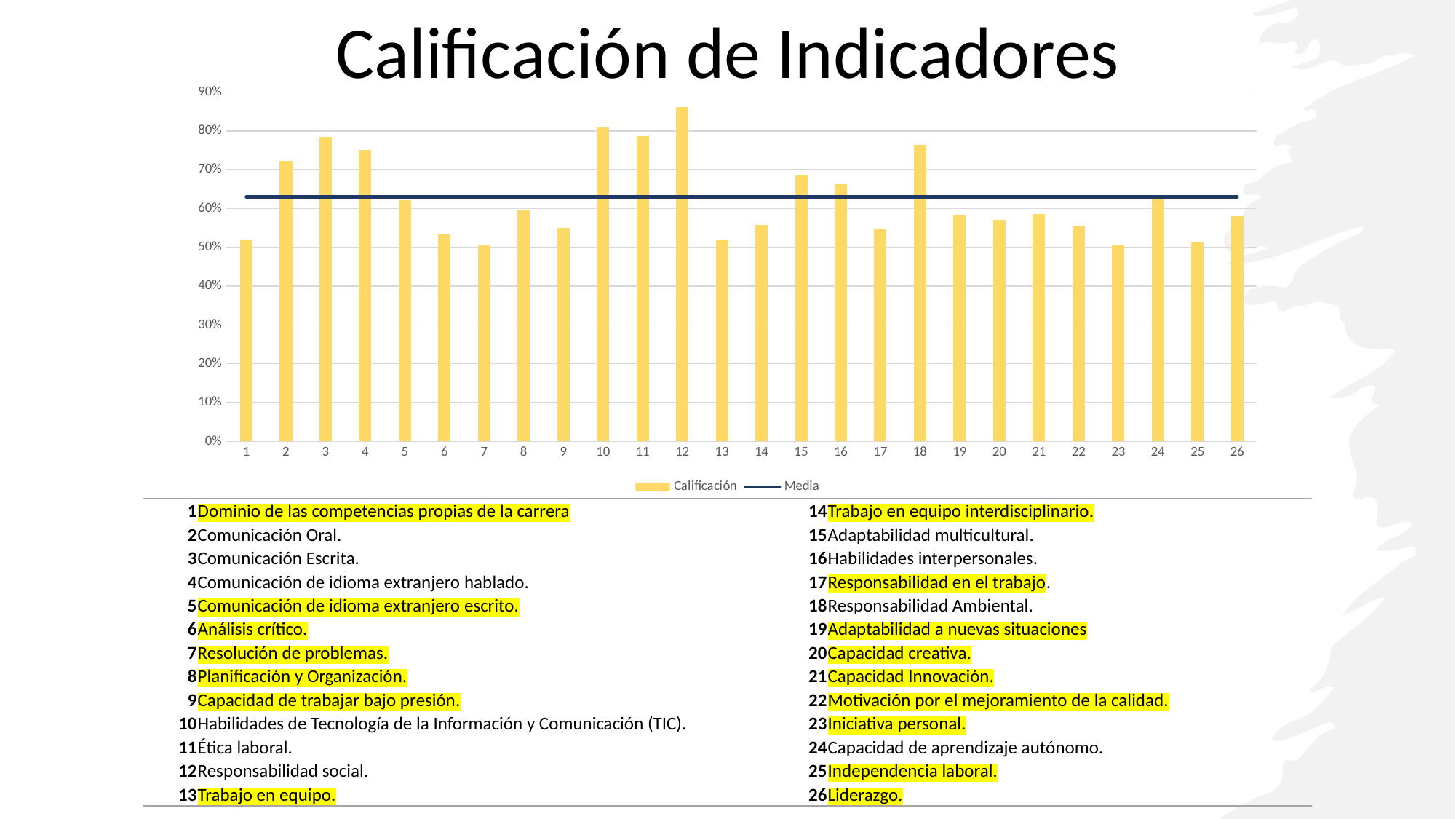
What is the title of the chart? Calificación de Indicadores Is the Calificación value for category 7 greater or less than 60%? less Which has the larger Calificación value, category 13 or category 10? 10 What kind of chart is shown on the slide? combination bar and line chart Which category has the highest Calificación bar? 12 Is the Calificación value for category 2 greater or less than 70%? greater What are the two entries in the chart legend? Calificación and Media How many categories are plotted along the x axis of the chart? 26 How many series does the chart legend list? 2 Which has the larger Calificación value, category 3 or category 6? 3 Is the Calificación value for category 12 greater or less than 80%? greater